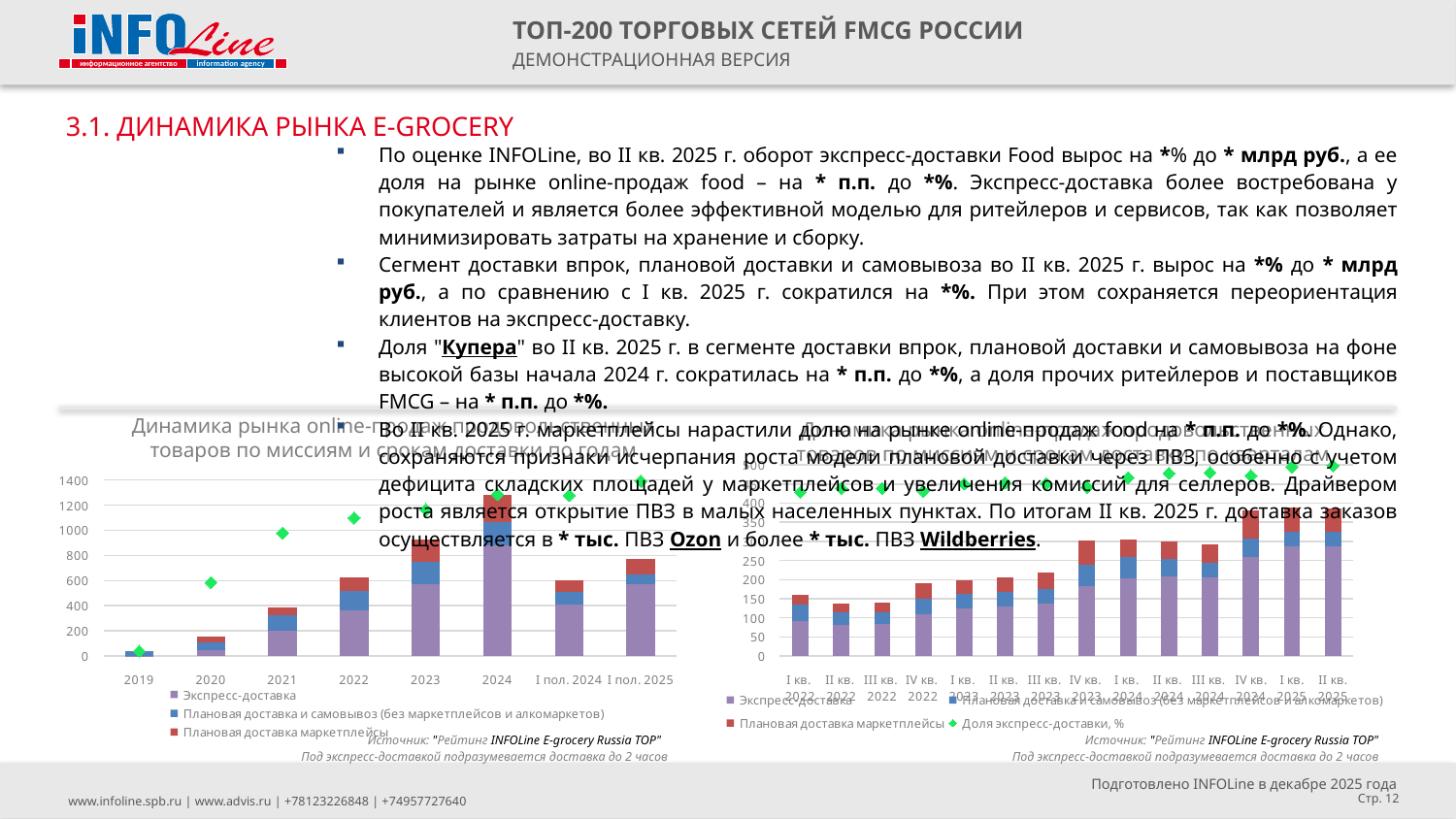
In the left chart (by year), do the total stacked bars rise or fall from 2019 to 2024? rise In the right chart (by quarter), how many series does the legend list? 4 In the left chart (by year), how many categories are shown on the x axis? 8 In the left chart (by year), which stacked bar is taller, 2022 or 2023? 2023 In the left chart (by year), which year has the tallest stacked bar? 2024 In the left chart (by year), is the total stacked bar for 2019 greater or less than 200? less What kind of chart is the left chart on the slide? combination bar and line chart (stacked bars with markers for the share series) In the right chart (by quarter), is the total stacked bar for II кв. 2025 greater or less than 350? greater In the left chart (by year), which category has the shortest stacked bar? 2019 In the left chart (by year), is the total stacked bar for 2024 greater or less than 1200? greater In the right chart (by quarter), how many categories are shown on the x axis? 14 In the right chart (by quarter), which stacked bar is taller, I кв. 2023 or I кв. 2024? I кв. 2024